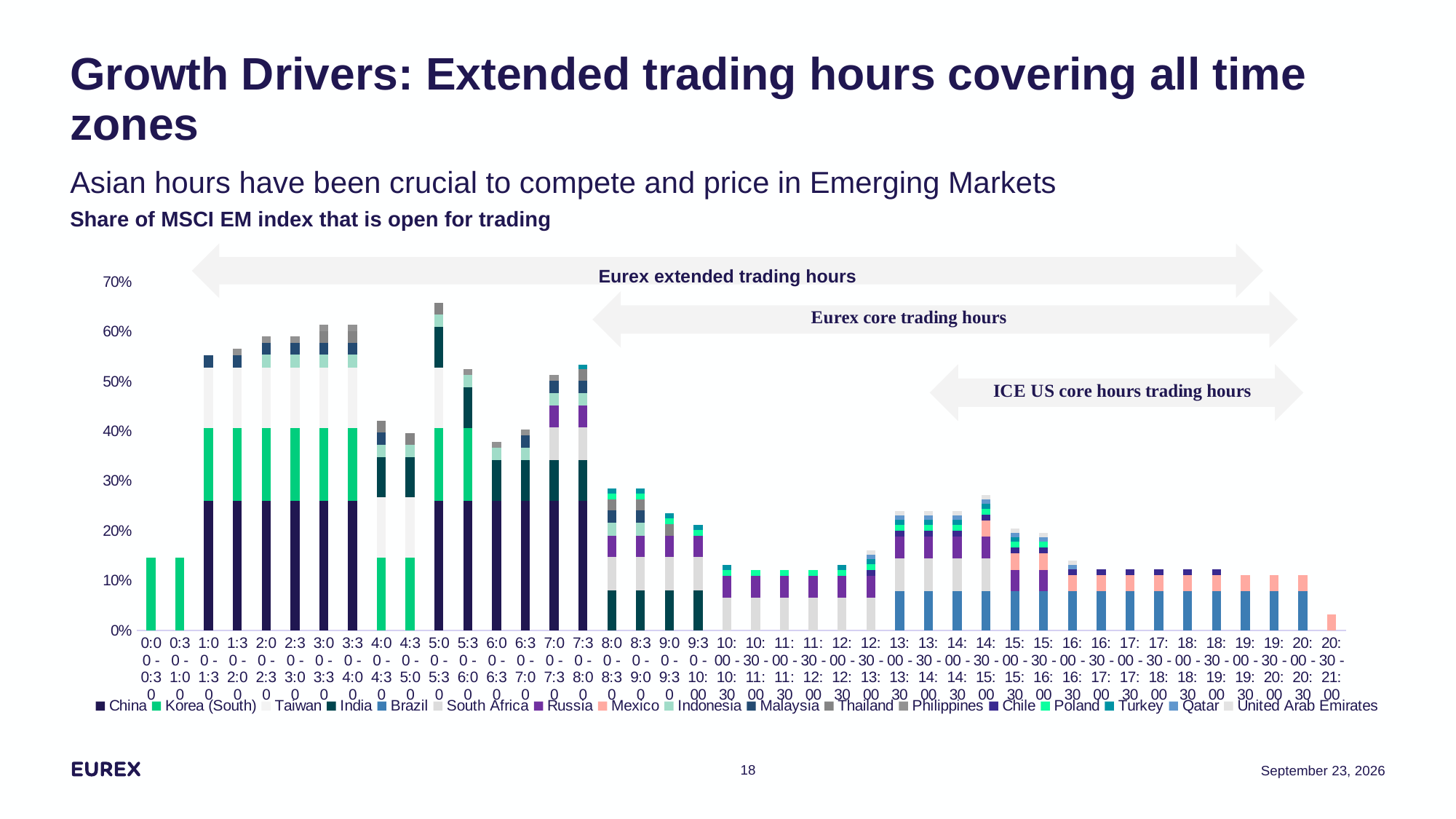
Is the total value for the 20:30 - 21:00 slot greater or less than 10%? less Is the total value for the 0:00 - 0:30 slot greater or less than 10%? greater Is the total value for the 10:30 - 11:00 slot greater or less than 20%? less How many series does the legend list? 17 Which time slot has the highest total share of the MSCI EM index open for trading? 5:00 - 5:30 From the 15:00 - 15:30 slot to the 20:30 - 21:00 slot, do the total values generally rise or fall? fall Which series is listed first in the legend? China What is the title of the chart? Share of MSCI EM index that is open for trading What kind of chart is shown on the slide? Stacked bar chart Which time slot has the lowest total share of the MSCI EM index open for trading? 20:30 - 21:00 Which has a larger total share: the 1:00 - 1:30 slot or the 8:00 - 8:30 slot? 1:00 - 1:30